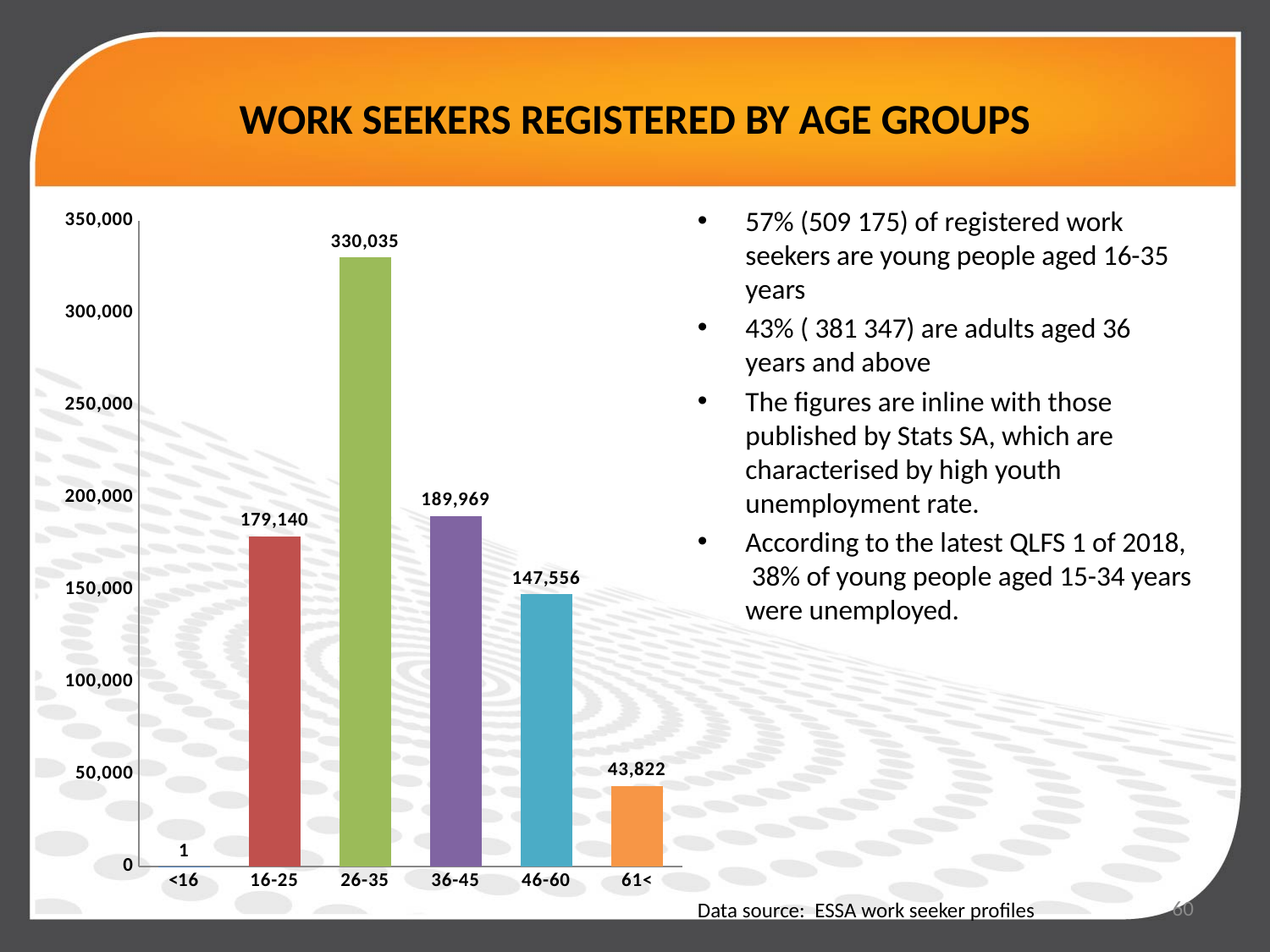
What is the difference between the values for the 26-35 and 46-60 age groups? 182,479 What is the difference between the values for the 36-45 and 16-25 age groups? 10,829 What is the number of registered work seekers in the 26-35 age group? 330,035 Which age group has more registered work seekers, 36-45 or 46-60? 36-45 What is the number of registered work seekers in the 61< age group? 43,822 What is the title of the chart on the slide? WORK SEEKERS REGISTERED BY AGE GROUPS What type of chart is used to show work seekers registered by age groups? bar chart Is the value for the 16-25 age group greater or less than 150,000? greater Which age group has the lowest number of registered work seekers? <16 What is the value shown for the <16 age group? 1 Which age group has the highest number of registered work seekers? 26-35 How many age groups are shown on the x axis of the chart? 6